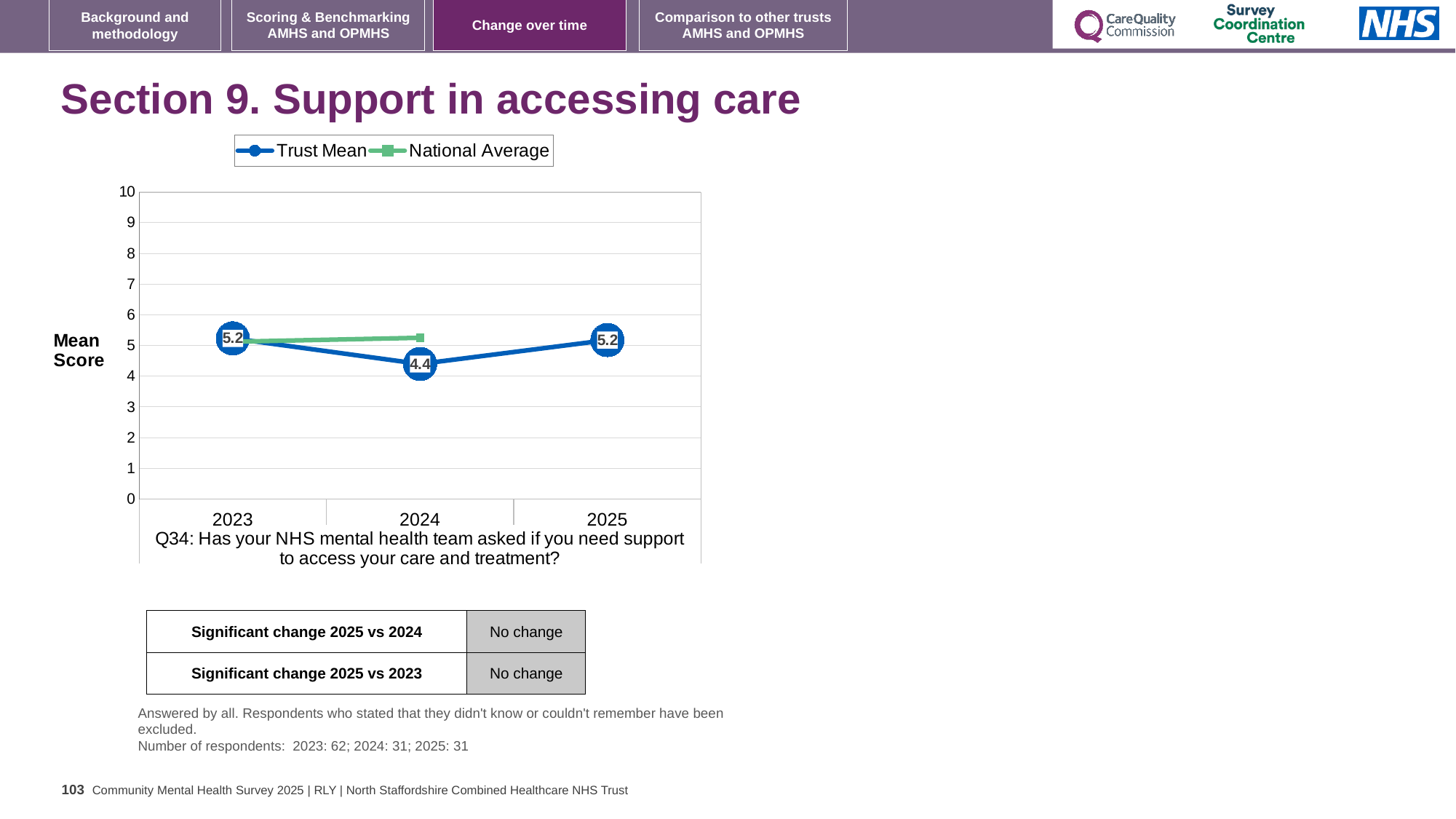
Which is larger, the Trust Mean for 2024 or for 2025? 2025 What is the difference between the Trust Mean in 2023 and in 2024? 0.8 What is the Trust Mean value for 2025? 5.2 What kind of chart is shown on the slide? line chart What is the Trust Mean value for 2024? 4.4 Is the National Average value for 2024 greater or less than 6? less In which year is the Trust Mean lowest? 2024 How does the Trust Mean change from 2023 to 2025? falls in 2024, then rises back in 2025 How many years are shown on the x axis? 3 What is the Trust Mean value for 2023? 5.2 What are the two series named in the legend? Trust Mean and National Average How many series does the legend list? 2